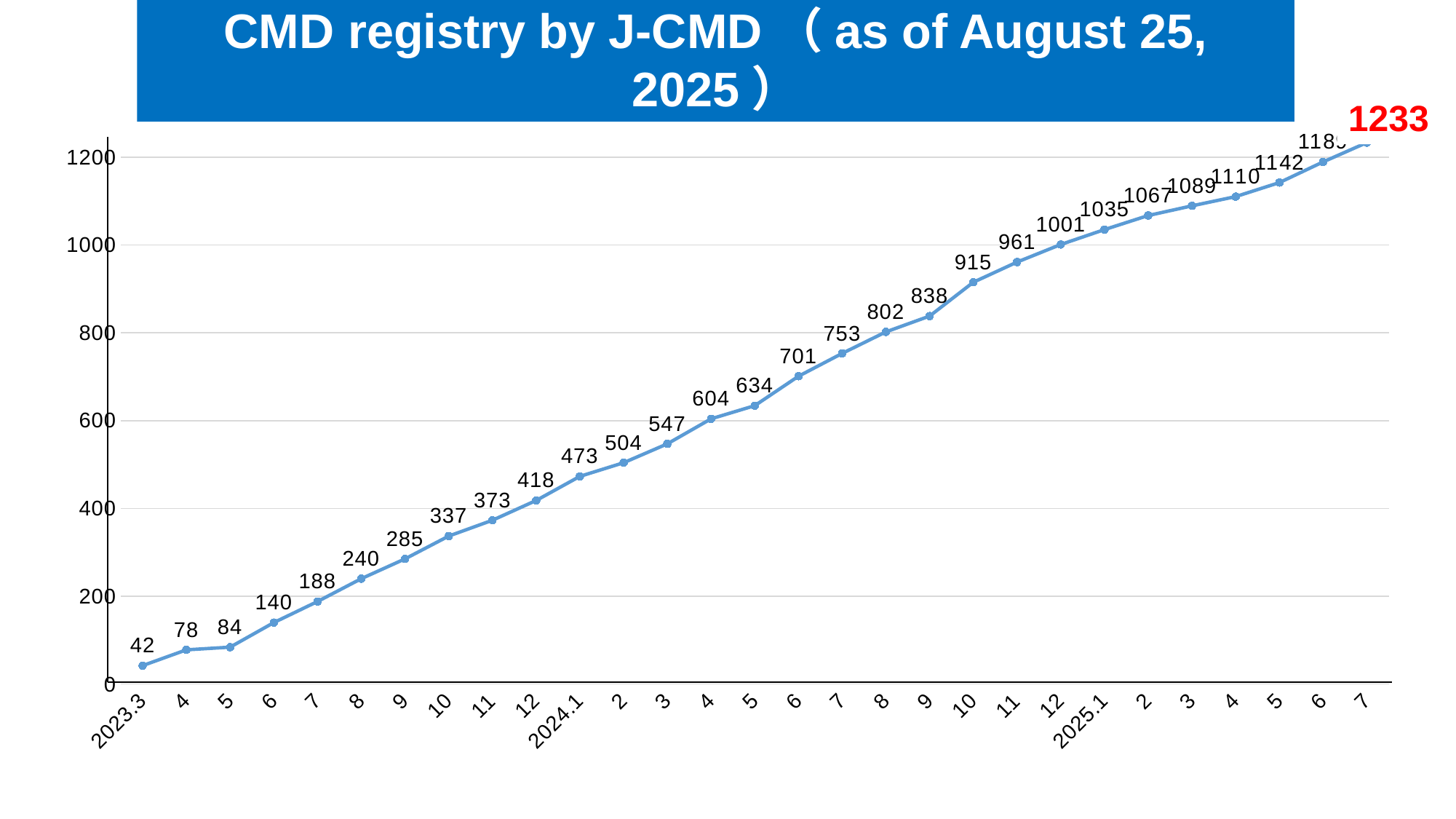
Which month has the highest value? 2025.7 Which month has the lowest value? 2023.3 What kind of chart is shown on the slide? line chart What is the value for 2023.3? 42 Which is larger, the value for 2023.12 or the value for 2024.3? 2024.3 What is the title of the chart? CMD registry by J-CMD (as of August 25, 2025) What is the value for 2025.7, shown in red? 1233 What is the value for 2024.1? 473 What is the value for 2025.1? 1035 Do the values rise or fall along the x axis? rise What is the value for 2024.10? 915 What is the difference between the values for 2024.12 and 2024.11? 40